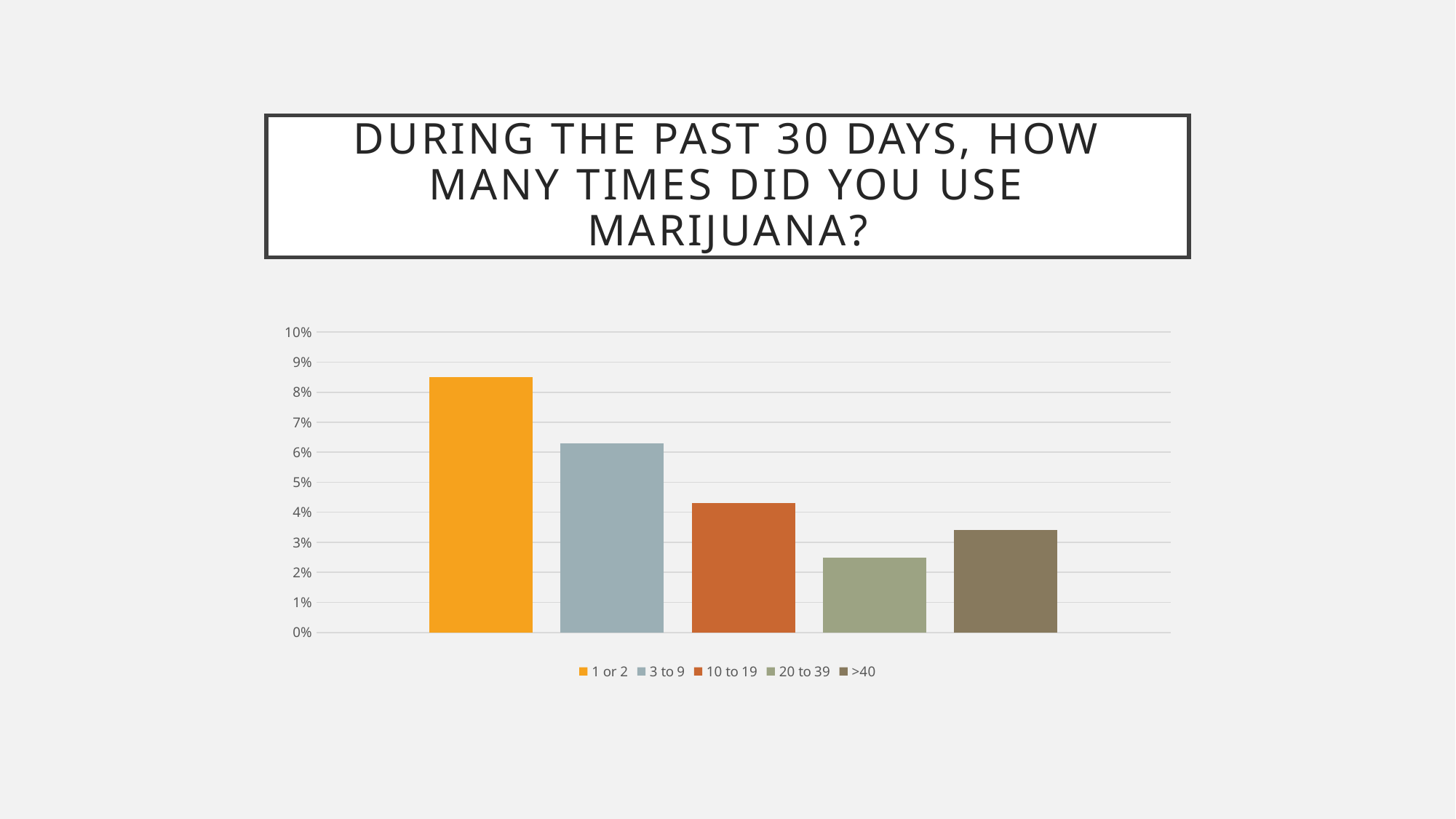
Which is larger, the value for "20 to 39" or the value for ">40"? >40 Is the value for "1 or 2" greater or less than 8%? greater Is the value for ">40" greater or less than 3%? greater Is the value for "20 to 39" greater or less than 3%? less What kind of chart is shown on the slide? bar chart How many entries does the legend list? 5 Which is larger, the value for "3 to 9" or the value for "10 to 19"? 3 to 9 Which category has the lowest bar? 20 to 39 Which category has the highest bar? 1 or 2 What is the title of the chart? During the past 30 days, how many times did you use marijuana?